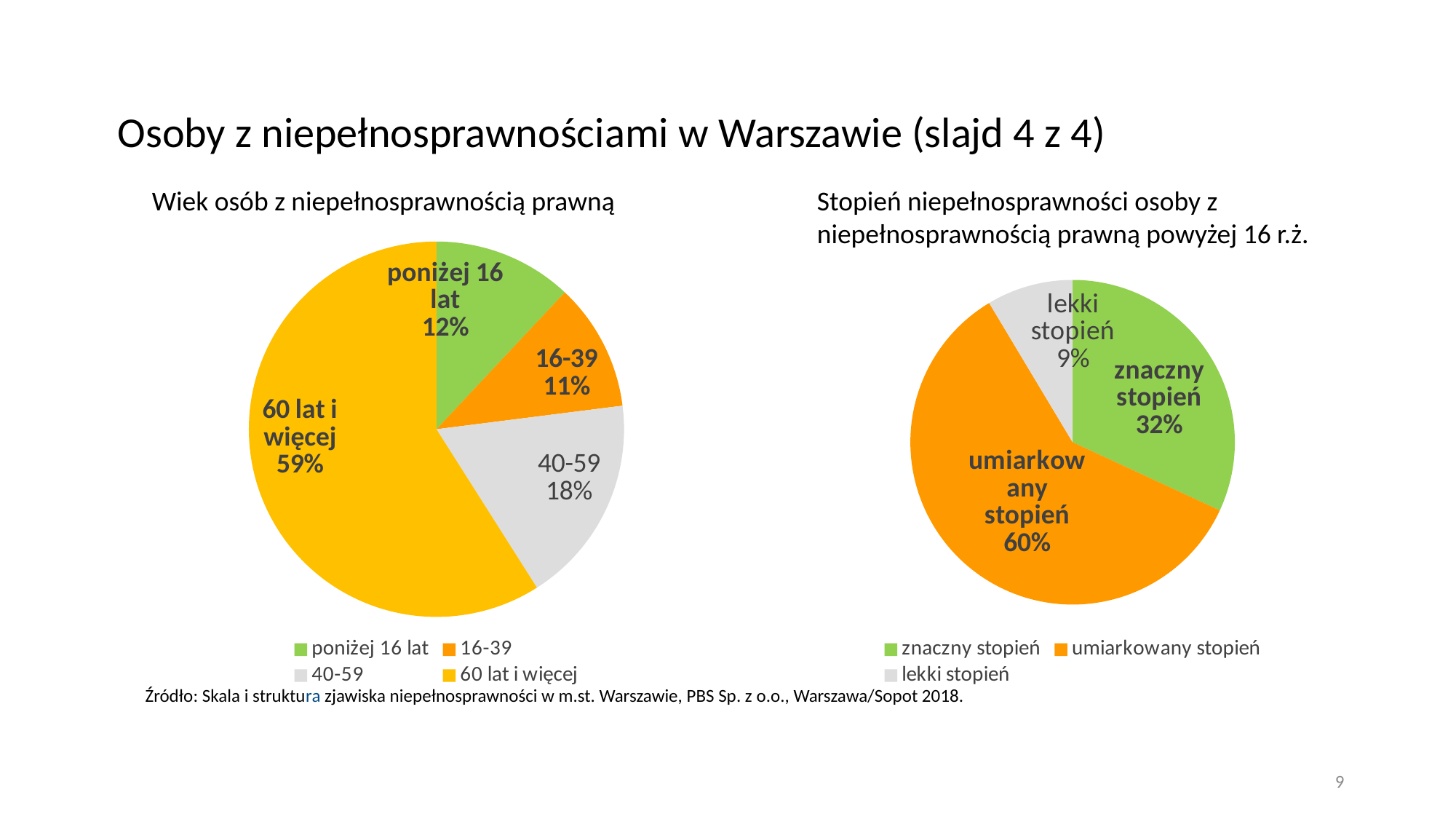
In the left chart 'Wiek osób z niepełnosprawnością prawną', which age group has the smallest share? 16-39 In the right chart 'Stopień niepełnosprawności', what share is shown for 'lekki stopień'? 9% In the left chart 'Wiek osób z niepełnosprawnością prawną', how many percentage points larger is '40-59' than 'poniżej 16 lat'? 6 In the left chart 'Wiek osób z niepełnosprawnością prawną', what share is shown for '40-59'? 18% In the left chart 'Wiek osób z niepełnosprawnością prawną', how many categories does the legend list? 4 In the right chart 'Stopień niepełnosprawności', how many percentage points larger is 'umiarkowany stopień' than 'znaczny stopień'? 28 In the right chart 'Stopień niepełnosprawności', what share is shown for 'umiarkowany stopień'? 60% In the left chart 'Wiek osób z niepełnosprawnością prawną', what share is shown for '60 lat i więcej'? 59% What type of chart is used on the right side of the slide? pie chart In the left chart 'Wiek osób z niepełnosprawnością prawną', which age group has the largest share? 60 lat i więcej In the right chart 'Stopień niepełnosprawności', what colour is the 'lekki stopień' slice? grey In the right chart 'Stopień niepełnosprawności', which category has the largest share? umiarkowany stopień